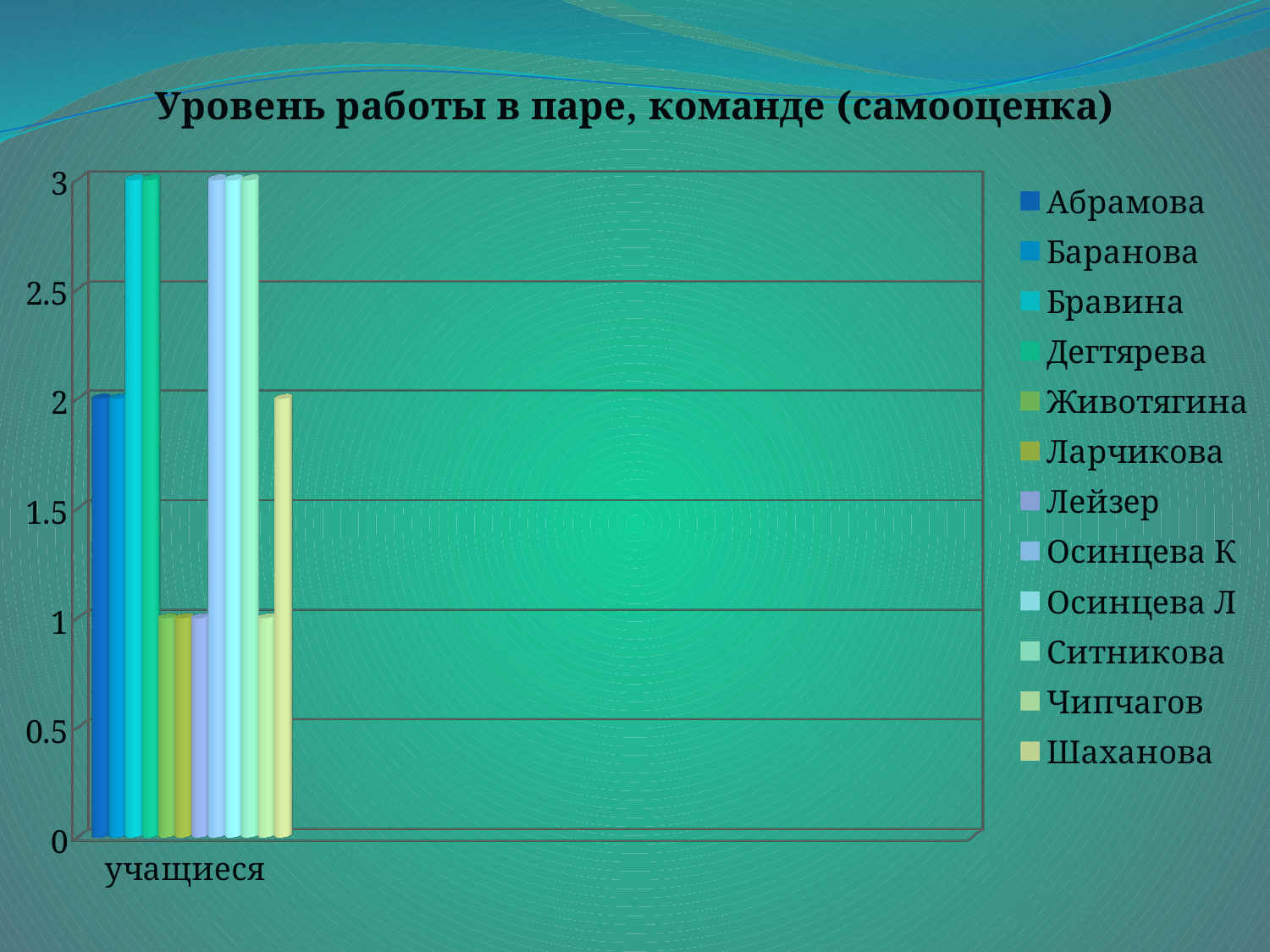
What type of chart is shown on the slide? bar chart What is the category label shown on the x axis? учащиеся What is the difference between the values for Дегтярева and Ларчикова? 2 What is the value for Абрамова? 2 Which is larger, the value for Осинцева К or the value for Чипчагов? Осинцева К Is the value for Баранова greater or less than 1.5? greater What is the title of the chart? Уровень работы в паре, команде (самооценка) How many series does the legend list? 12 What is the value for Шаханова? 2 Is the value for Лейзер greater or less than 1.5? less What is the value for Животягина? 1 What is the value for Бравина? 3